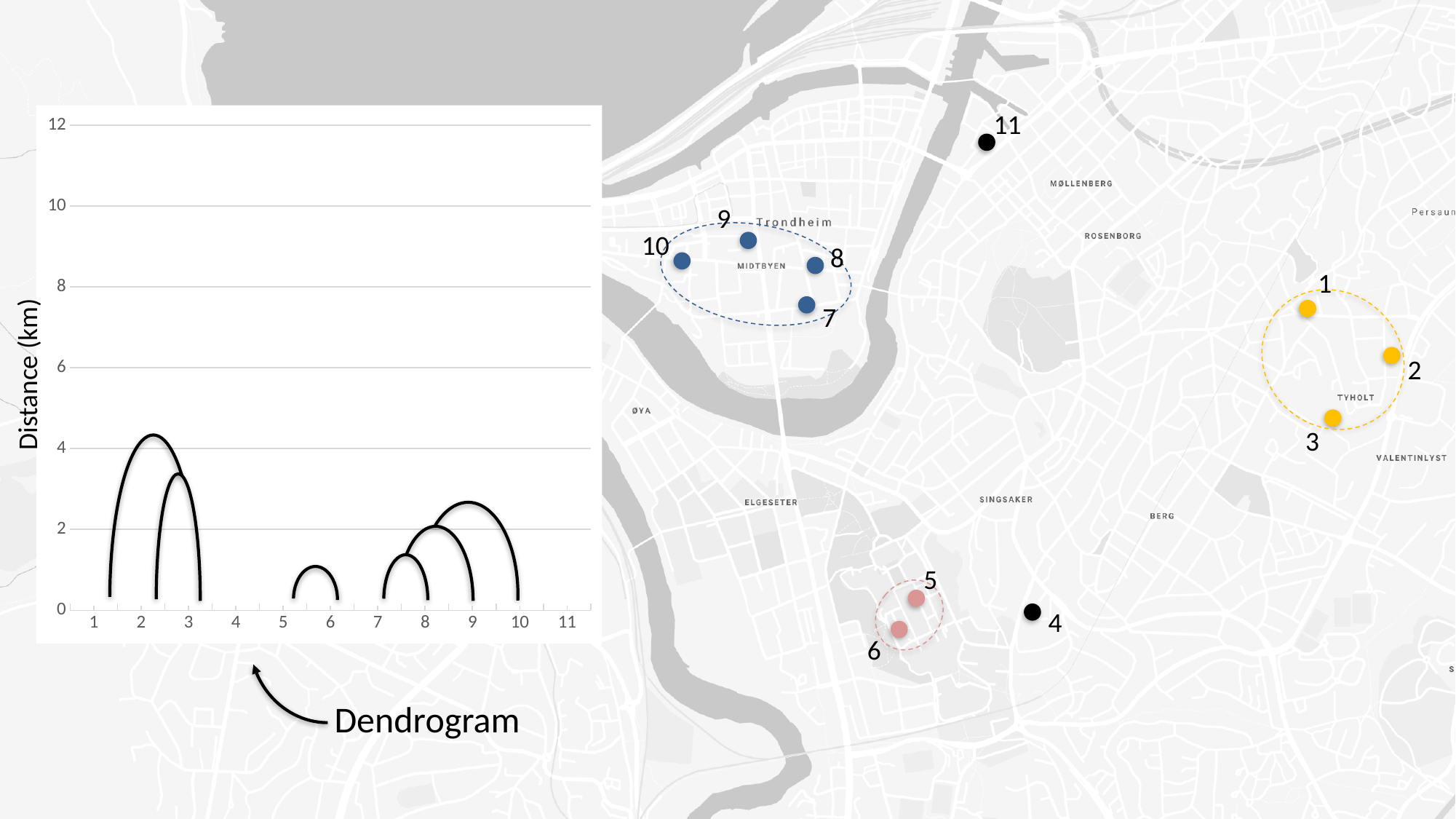
Is the peak of the outermost arch over points 7 to 10 in the dendrogram greater or less than 2 km? greater Is the peak of the inner arch joining points 2 and 3 in the dendrogram greater or less than 2 km? greater Is the peak of the tallest arch in the dendrogram (spanning points 1 to 3) greater or less than 4 km? greater Which group of points is joined by the tallest arch in the dendrogram? Points 1 to 3 What kind of chart is shown on the left of the slide? Dendrogram Which numbered points on the dendrogram's horizontal axis are not joined by any arch? 4 and 11 How many numbered points are marked along the horizontal axis of the dendrogram? 11 What is the label of the vertical axis of the dendrogram? Distance (km) What is the highest value shown on the vertical axis of the dendrogram? 12 In the dendrogram, which arch reaches higher: the one spanning points 1 to 3 or the one spanning points 7 to 10? Points 1 to 3